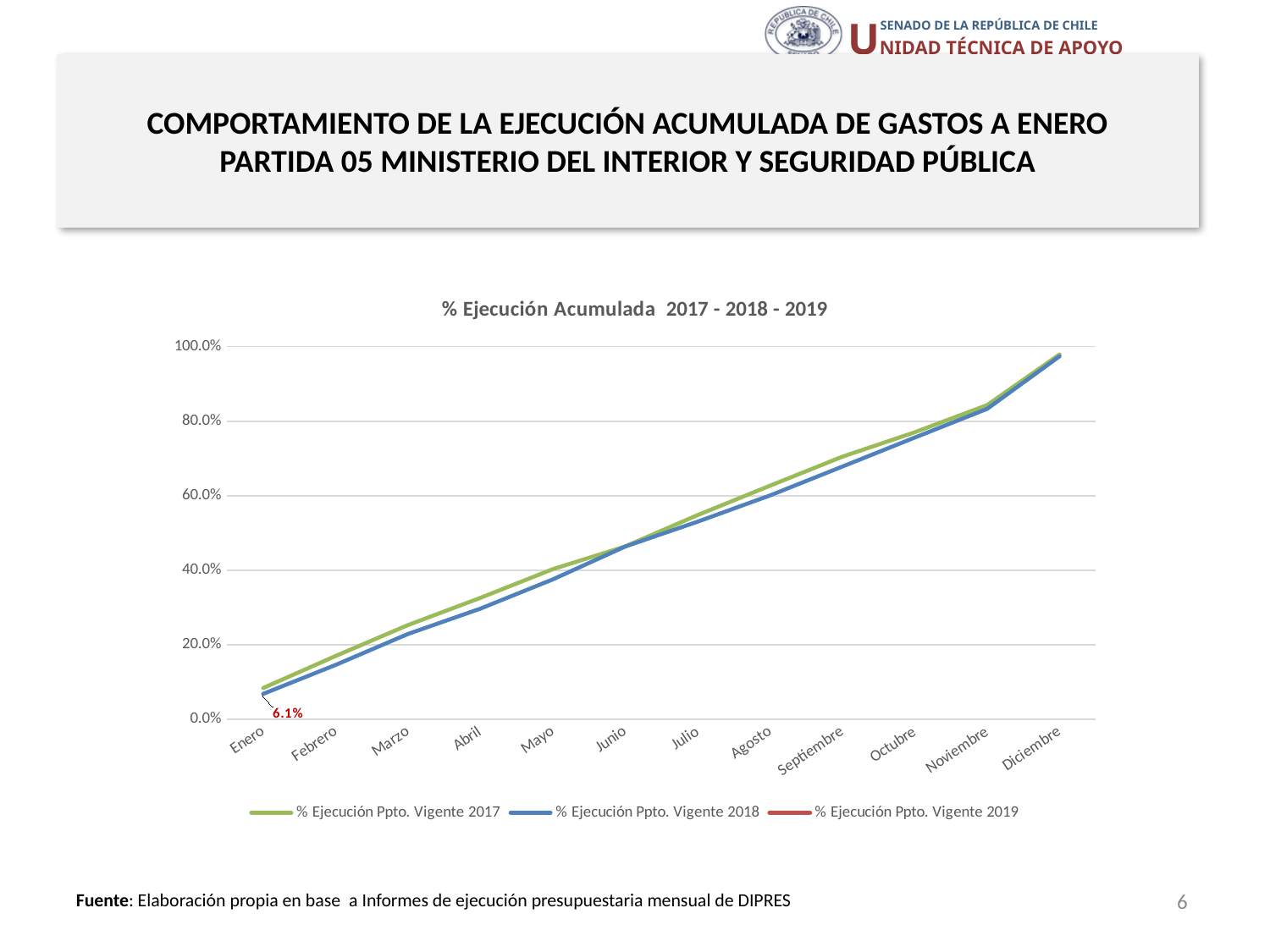
How many series does the legend list? 3 Is the value for % Ejecución Ppto. Vigente 2018 in Marzo greater or less than 40.0%? less What is the value of % Ejecución Ppto. Vigente 2019 for Enero? 6.1% Is the value for % Ejecución Ppto. Vigente 2017 in Diciembre greater or less than 80.0%? greater Is the value for % Ejecución Ppto. Vigente 2017 in Junio greater or less than 60.0%? less What kind of chart is shown on the slide? line chart In which month is the value for % Ejecución Ppto. Vigente 2017 highest? Diciembre Do the values for % Ejecución Ppto. Vigente 2017 rise or fall from Enero to Diciembre? rise What is the title of the chart? % Ejecución Acumulada 2017 - 2018 - 2019 In which month is the value for % Ejecución Ppto. Vigente 2018 lowest? Enero How many months are shown on the x axis? 12